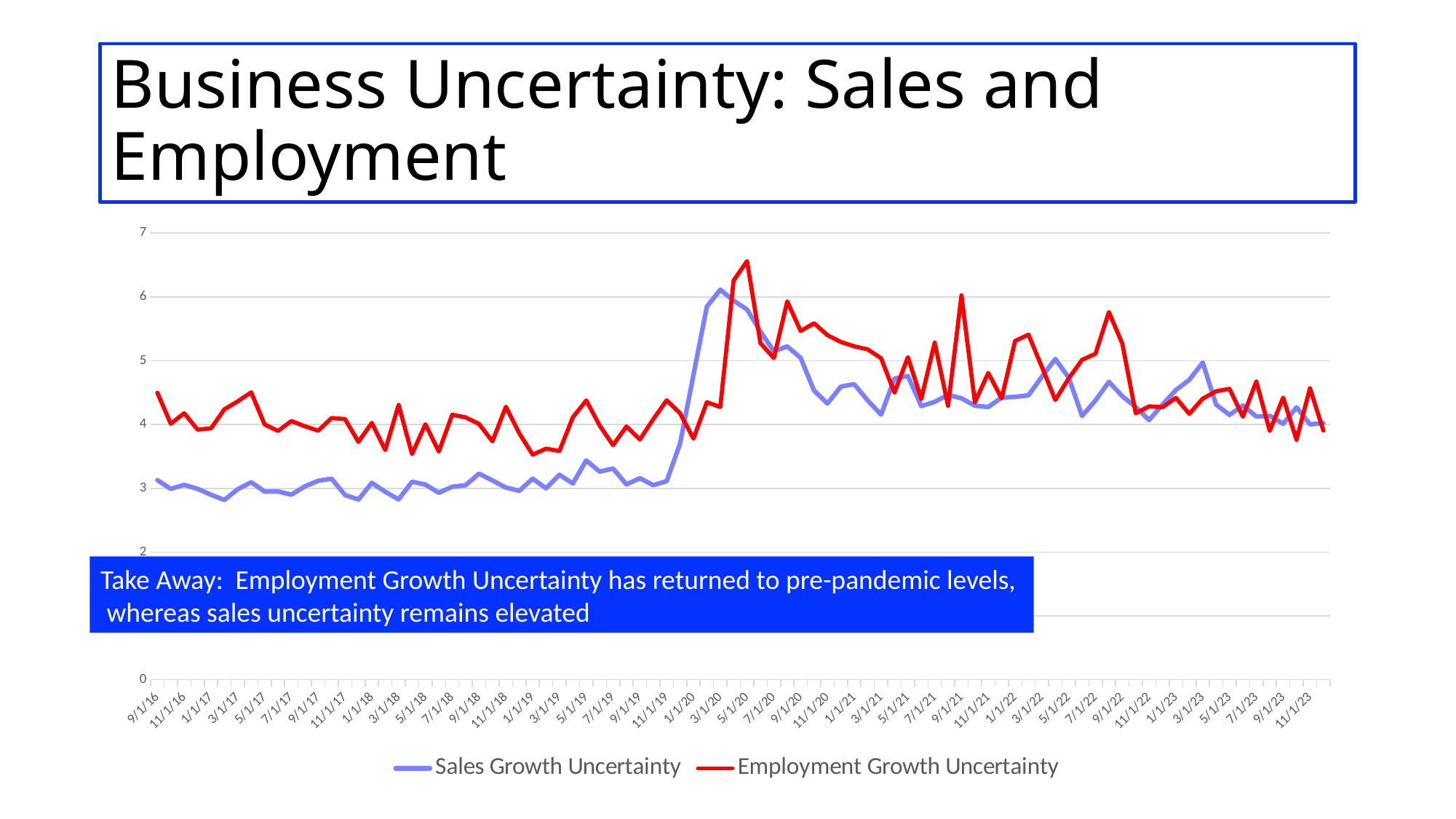
Is the value for Employment Growth Uncertainty at 9/1/16 greater or less than 4? greater Does Sales Growth Uncertainty rise or fall between 11/1/19 and 3/1/20? rise Is the value for Sales Growth Uncertainty at 3/1/20 greater or less than 5? greater At 3/1/20, which series has the higher value, Sales Growth Uncertainty or Employment Growth Uncertainty? Sales Growth Uncertainty Is the peak value of Employment Growth Uncertainty around 5/1/20 greater or less than 6? greater Which series is drawn in blue? Sales Growth Uncertainty At 9/1/16, which series has the higher value, Sales Growth Uncertainty or Employment Growth Uncertainty? Employment Growth Uncertainty How many series does the legend list? 2 What kind of chart is shown on the slide? line chart Which series is drawn in red? Employment Growth Uncertainty Which series reaches the highest peak on the chart? Employment Growth Uncertainty